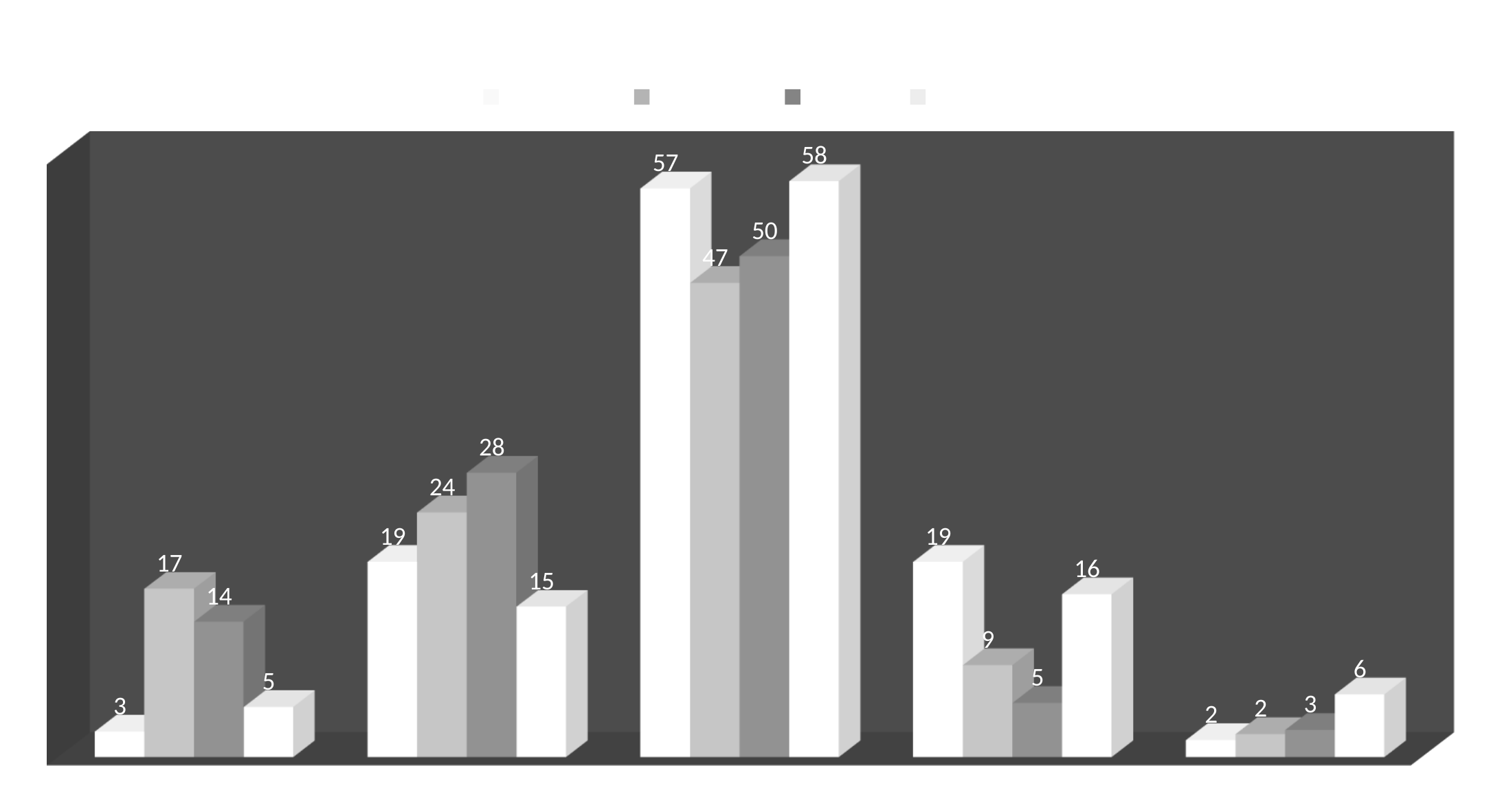
What is the value of the third bar in the second group from the left? 28 How many series does the legend show? 4 What is the lowest data label shown on the chart? 2 What is the total of the four bars in the rightmost group? 13 How many groups of bars are plotted along the x axis? 5 Which group of bars has the tallest bars overall? the middle (third) group What is the difference between the fourth bar (58) and the second bar (47) in the middle group? 11 What is the value of the fourth bar in the fourth group from the left? 16 What is the highest data label shown on the chart? 58 What kind of chart is shown on the slide? bar chart What is the value of the first (leftmost) bar in the middle group? 57 In the leftmost group, which is larger: the second bar or the third bar? the second bar (17)